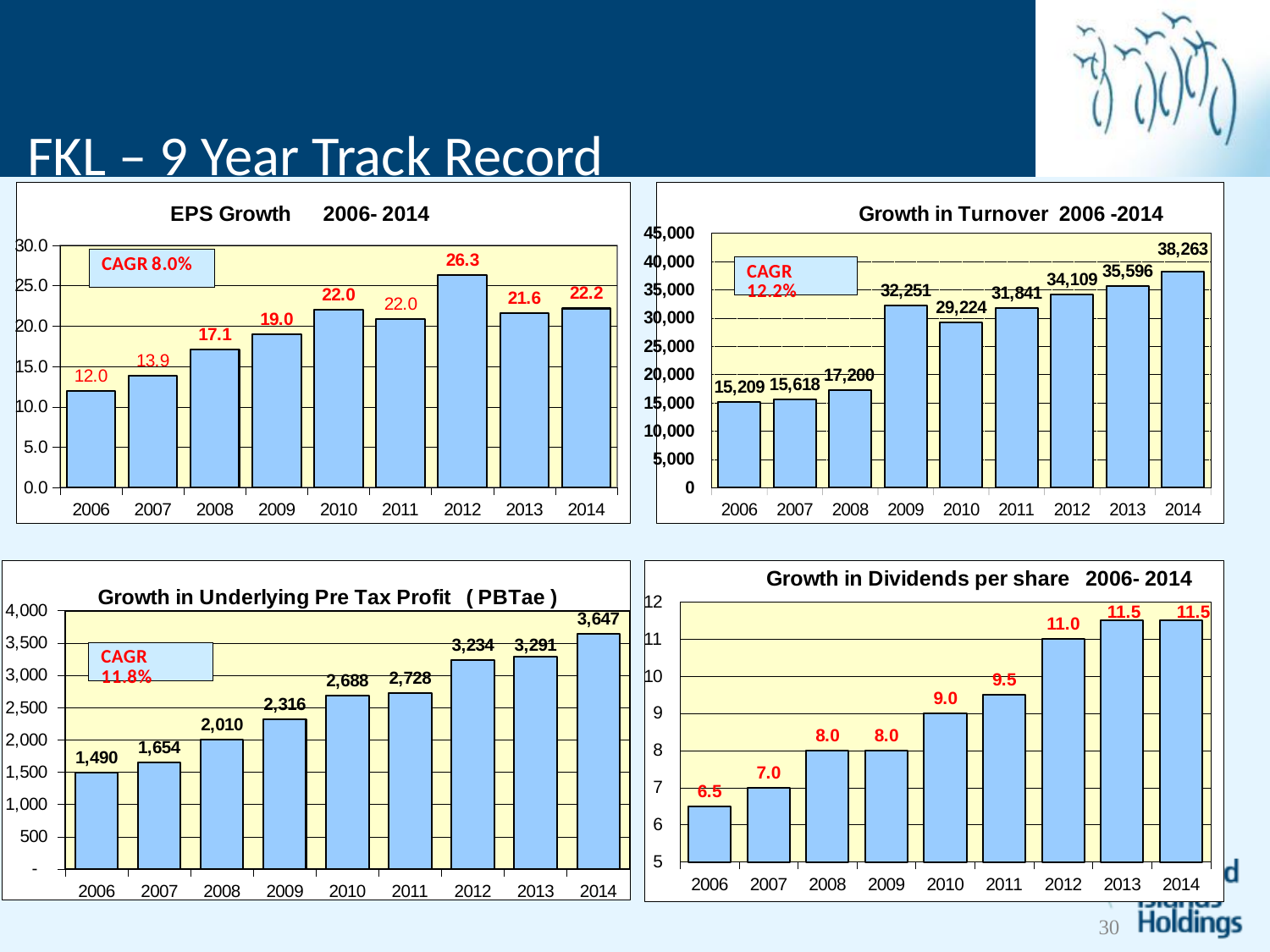
What CAGR is shown on the Growth in Underlying Pre Tax Profit (PBTae) chart? 11.8% In the Growth in Turnover 2006-2014 chart, which year has the highest value? 2014 In the Growth in Underlying Pre Tax Profit (PBTae) chart, what is the value for 2010? 2,688 In the Growth in Turnover 2006-2014 chart, what is the difference between the 2014 value and the 2006 value? 23,054 In the Growth in Dividends per share 2006-2014 chart, what is the difference between the 2014 value and the 2006 value? 5.0 In the Growth in Turnover 2006-2014 chart, what is the value for 2009? 32,251 In the EPS Growth 2006-2014 chart, which year has the lowest value? 2006 In the EPS Growth 2006-2014 chart, what is the value for 2012? 26.3 What kind of chart is the Growth in Turnover 2006-2014 chart? Bar chart In the Growth in Underlying Pre Tax Profit (PBTae) chart, is the value for 2012 larger than the value for 2011? Yes, 2012 In the Growth in Dividends per share 2006-2014 chart, what is the value for 2011? 9.5 How many years are plotted in the Growth in Dividends per share 2006-2014 chart? 9